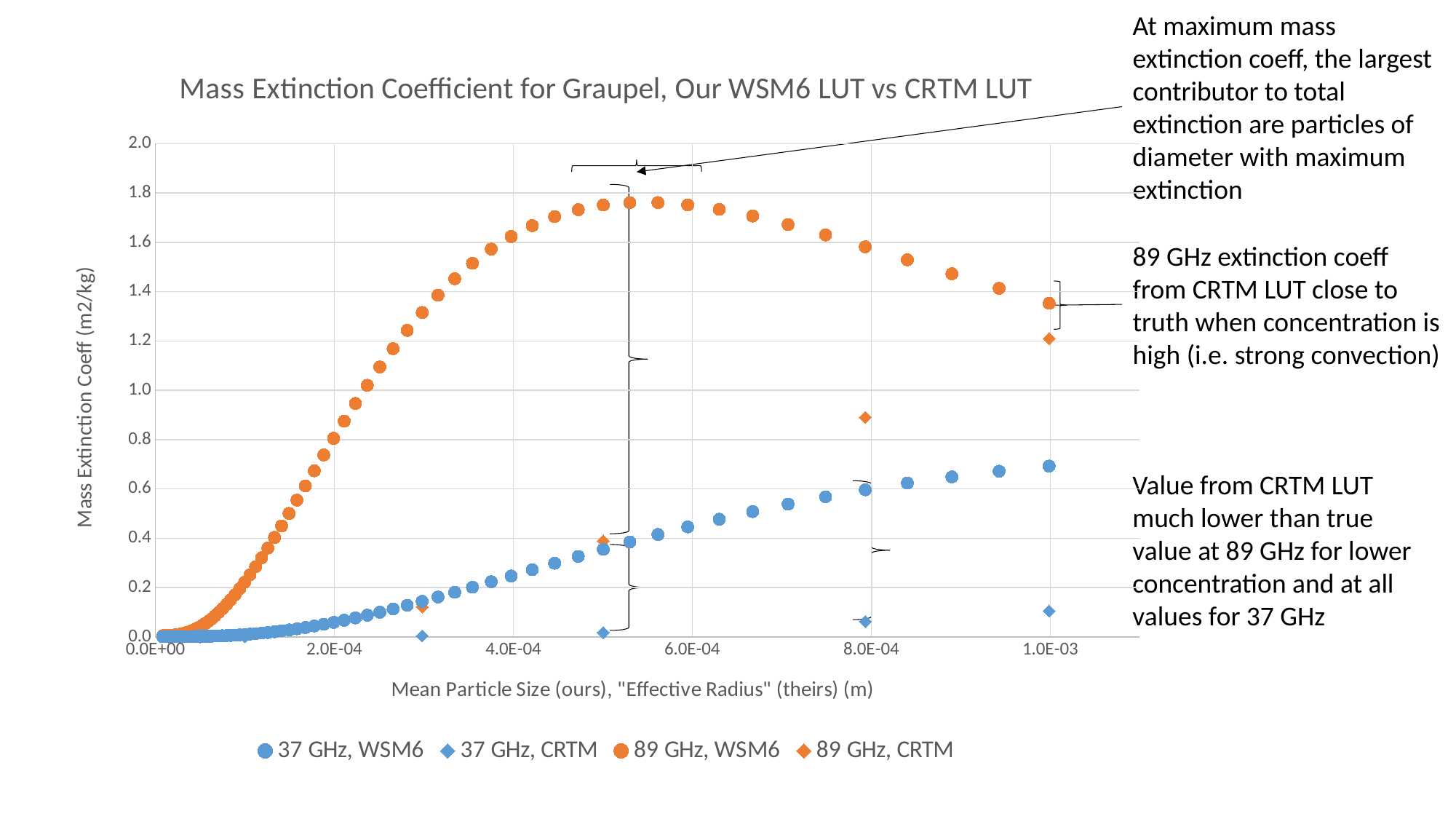
Which series reaches the highest mass extinction coefficient on the chart? 89 GHz, WSM6 How many series does the legend list? 4 Does the 37 GHz, WSM6 series rise or fall as mean particle size increases? rise What is the label of the y axis? Mass Extinction Coeff (m2/kg) What kind of chart is shown on the slide? Scatter chart Is the value of the 89 GHz, CRTM series at 1.0E-03 greater or less than 1.0? greater Is the value of the 37 GHz, WSM6 series at 1.0E-03 greater or less than 0.8? less Is the value of the 37 GHz, CRTM series at 1.0E-03 greater or less than 0.2? less What is the title of the chart? Mass Extinction Coefficient for Graupel, Our WSM6 LUT vs CRTM LUT At 1.0E-03, which series has the larger value: 89 GHz, WSM6 or 89 GHz, CRTM? 89 GHz, WSM6